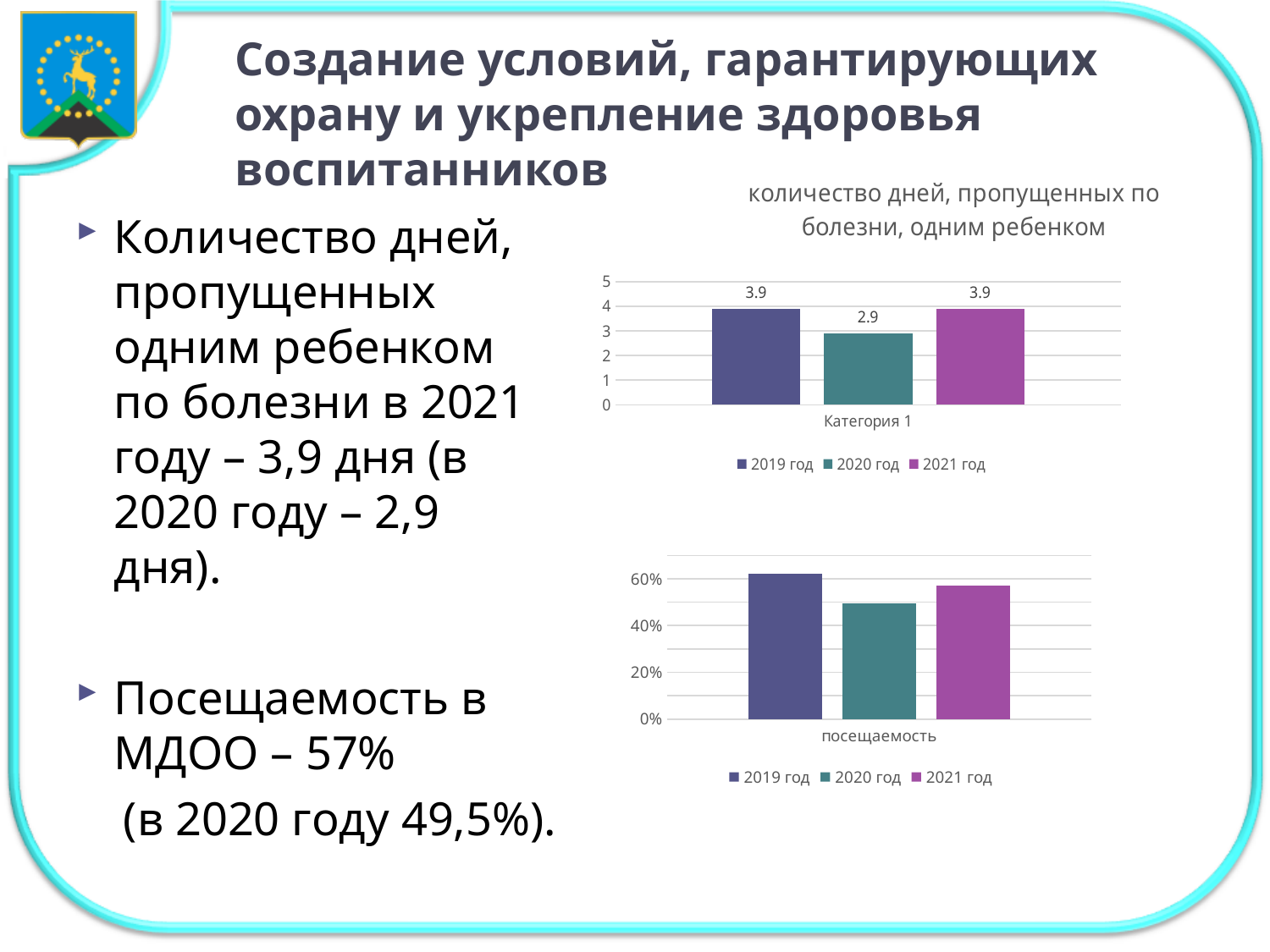
In the top chart (количество дней, пропущенных по болезни, одним ребенком), is the value for 2020 год greater or less than the value for 2021 год? less In the bottom chart (посещаемость), which year has the lowest value? 2020 год In the top chart (количество дней, пропущенных по болезни, одним ребенком), which year has the lowest value? 2020 год In the top chart (количество дней, пропущенных по болезни, одним ребенком), what is the difference between the 2019 год and 2020 год values? 1 In the bottom chart (посещаемость), is the value for 2021 год greater or less than 60%? less In the bottom chart (посещаемость), is the value for 2020 год greater or less than 40%? greater In the top chart (количество дней, пропущенных по болезни, одним ребенком), what is the value for 2020 год? 2.9 What kind of chart is the bottom chart (посещаемость)? bar chart In the top chart (количество дней, пропущенных по болезни, одним ребенком), what is the value for 2019 год? 3.9 What is the title of the top chart on the slide? количество дней, пропущенных по болезни, одним ребенком In the top chart (количество дней, пропущенных по болезни, одним ребенком), what is the value for 2021 год? 3.9 How many series does the legend of the top chart (количество дней, пропущенных по болезни, одним ребенком) list? 3